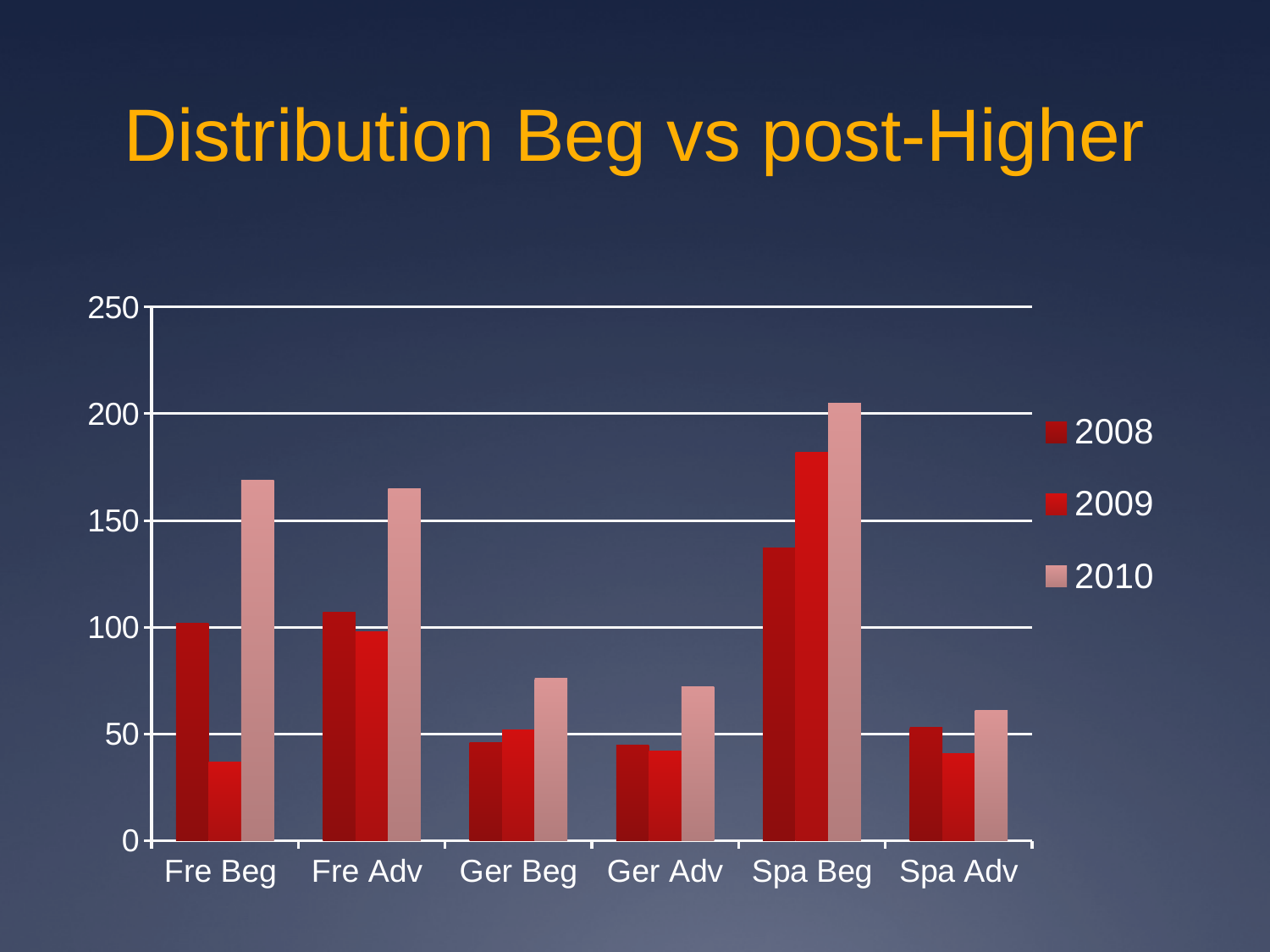
Which is larger, the 2009 value for Spa Beg or the 2009 value for Fre Adv? Spa Beg How many series does the chart's legend list? 3 What is the title of the slide containing the chart? Distribution Beg vs post-Higher Is the 2009 value for Fre Beg greater or less than 50? less For Fre Beg, which series has the larger value, 2008 or 2010? 2010 Which category has the highest value for the 2010 series? Spa Beg What are the entries listed in the chart's legend? 2008, 2009, 2010 Is the 2010 value for Spa Beg greater or less than 150? greater Is the 2010 value for Ger Beg greater or less than 100? less Which category has the lowest value for the 2010 series? Spa Adv How many categories are shown on the x axis of the chart? 6 What kind of chart is shown on the slide? bar chart